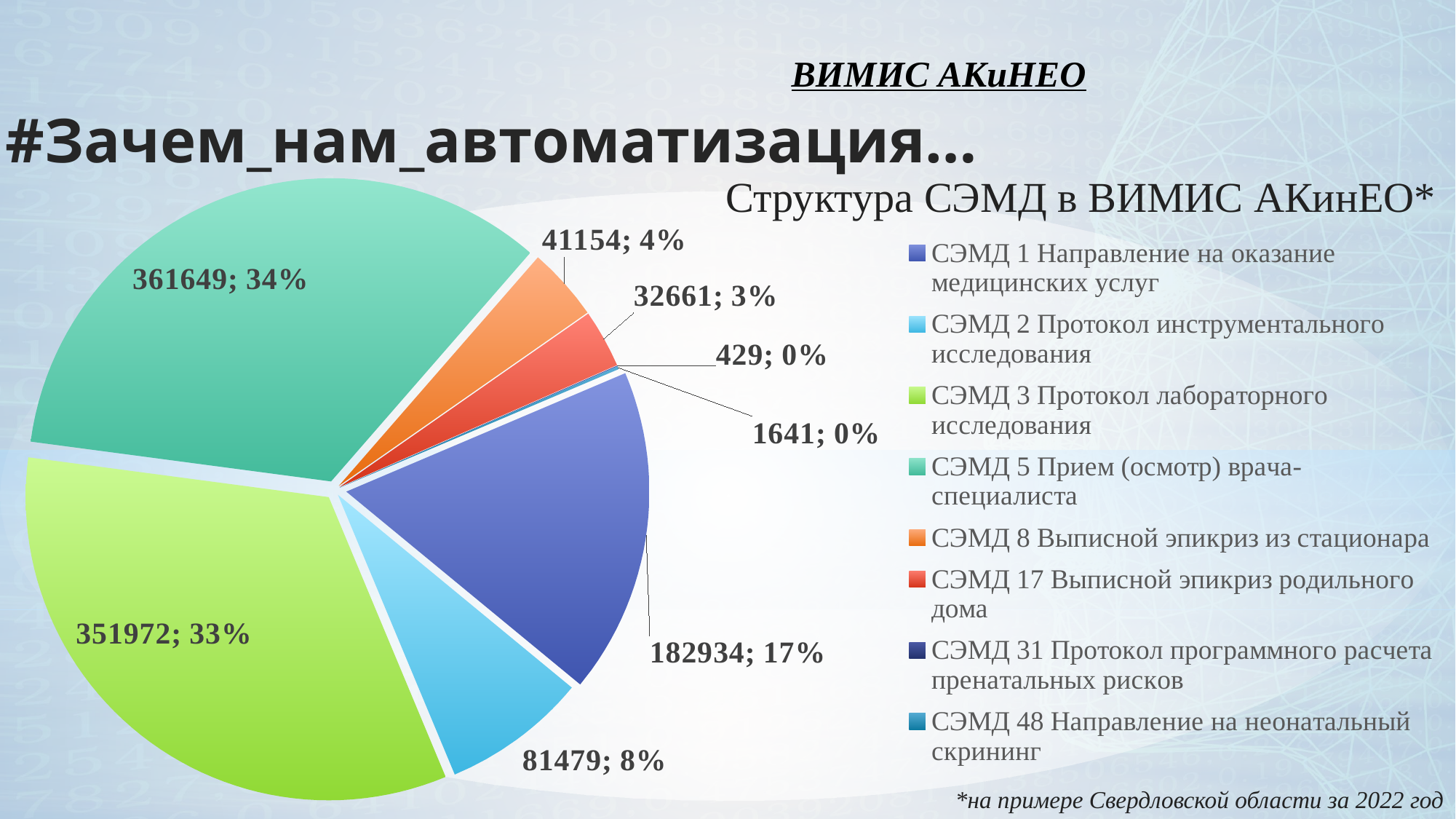
What is the value shown for СЭМД 1 Направление на оказание медицинских услуг? 182934 What is the value shown for СЭМД 8 Выписной эпикриз из стационара? 41154 What is the value shown for СЭМД 5 Прием (осмотр) врача-специалиста? 361649 What is the smallest value labelled on the pie chart? 429 Which category has the largest slice of the pie? СЭМД 5 Прием (осмотр) врача-специалиста What is the difference between the values for СЭМД 5 and СЭМД 3? 9677 What percentage share does СЭМД 2 Протокол инструментального исследования have? 8% What is the value shown for СЭМД 17 Выписной эпикриз родильного дома? 32661 What percentage share does СЭМД 3 Протокол лабораторного исследования have? 33% How many entries does the legend of the pie chart list? 8 Which is larger, the value for СЭМД 1 or the value for СЭМД 2? СЭМД 1 What type of chart is shown on the slide? Pie chart